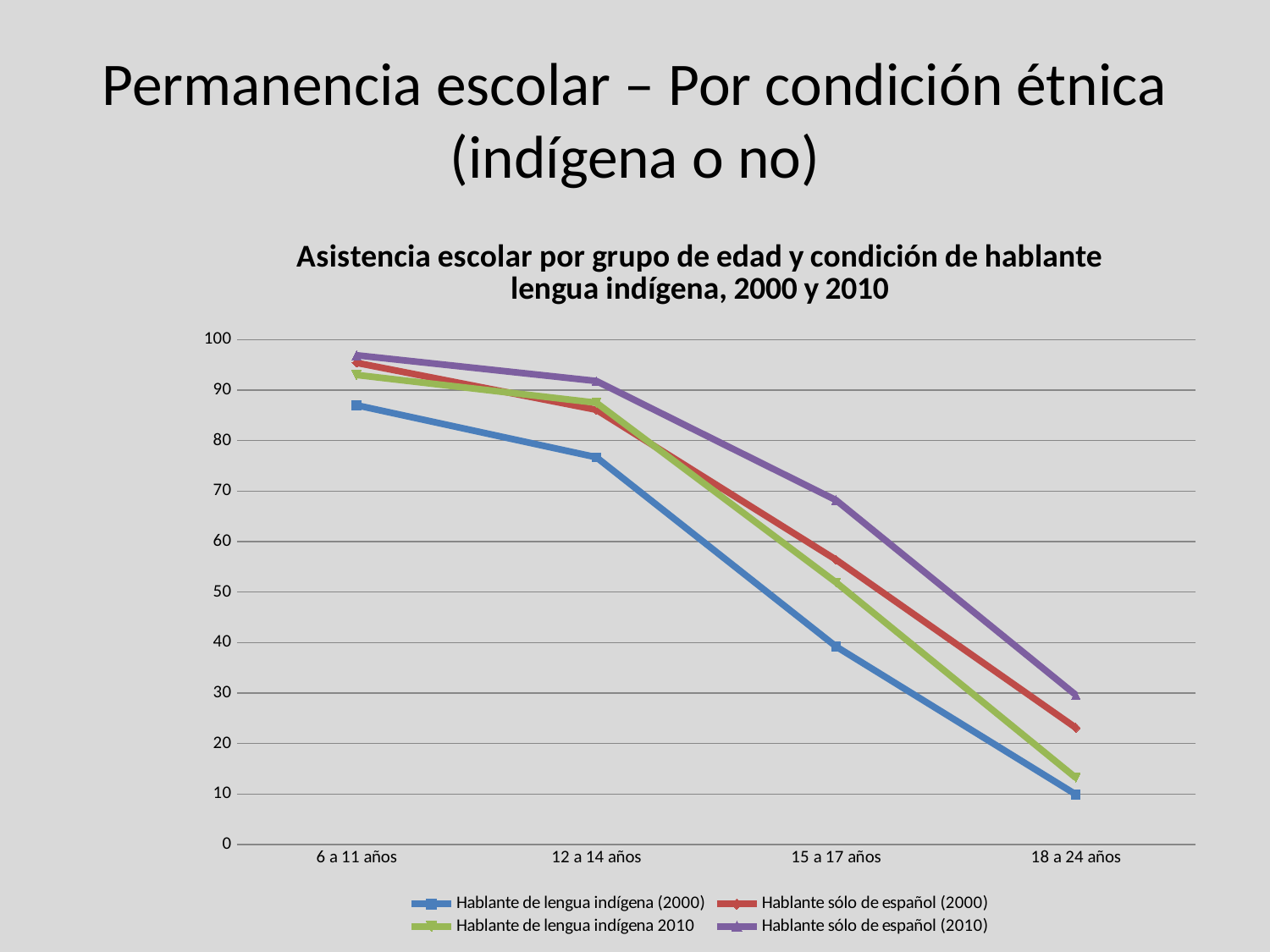
Is the value for 'Hablante de lengua indígena (2000)' at '18 a 24 años' greater or less than 20? less Is the value for 'Hablante de lengua indígena (2000)' at '15 a 17 años' greater or less than 50? less At '18 a 24 años', which is larger: 'Hablante sólo de español (2010)' or 'Hablante de lengua indígena (2000)'? Hablante sólo de español (2010) Is the value for 'Hablante sólo de español (2000)' at '12 a 14 años' greater or less than 80? greater What is the title of the chart? Asistencia escolar por grupo de edad y condición de hablante lengua indígena, 2000 y 2010 Which series has the lowest value at '6 a 11 años'? Hablante de lengua indígena (2000) How many age groups are shown on the x axis of the chart? 4 Do the values for 'Hablante de lengua indígena (2000)' rise or fall from '6 a 11 años' to '18 a 24 años'? Fall How many series does the legend of the chart list? 4 Which series has the highest value at '15 a 17 años'? Hablante sólo de español (2010) What kind of chart is shown on the slide? Line chart